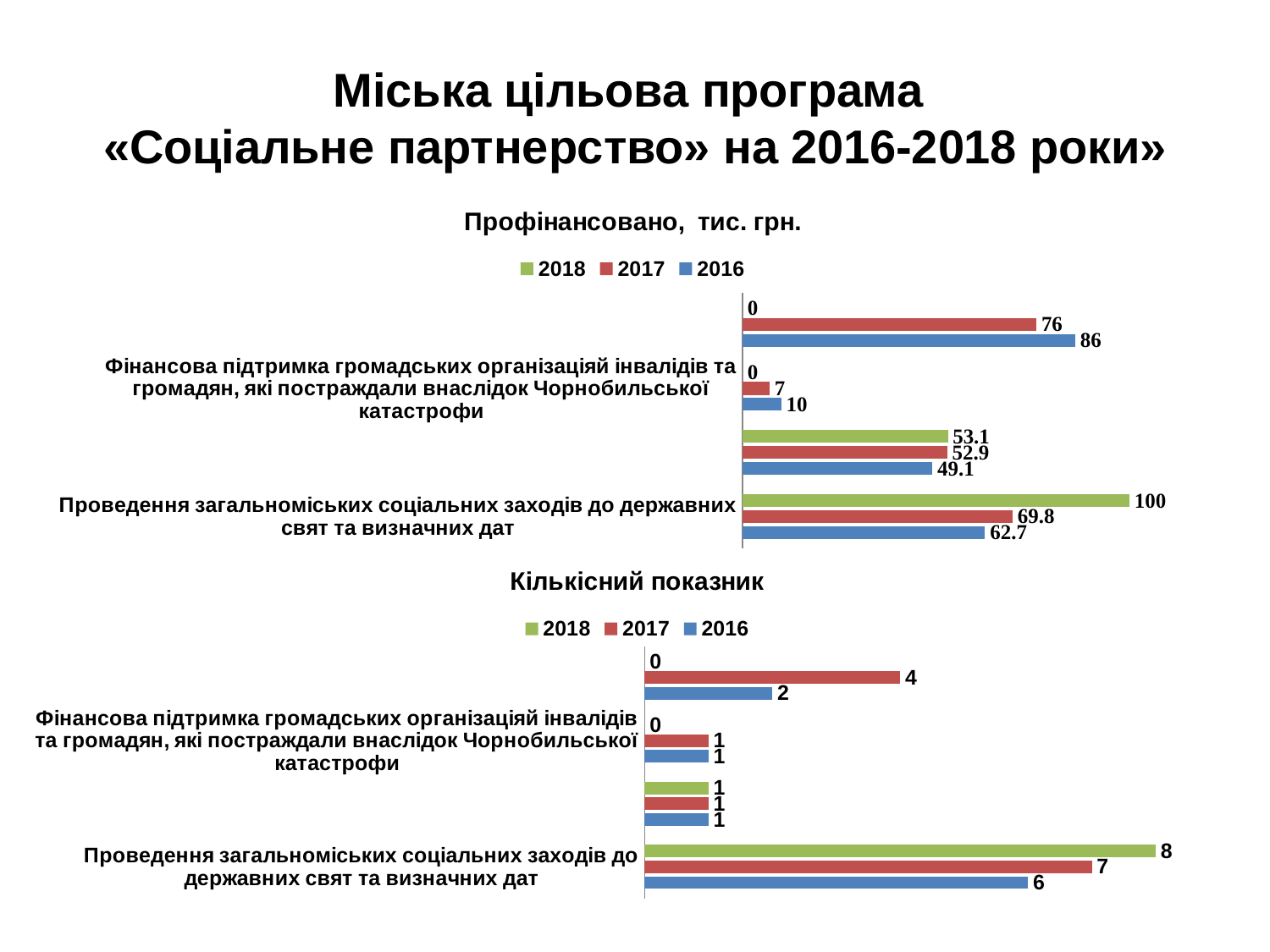
In the "Профінансовано, тис. грн." chart, what is the 2016 value in the bottom group of bars? 62.7 In the "Профінансовано, тис. грн." chart, what is the 2016 value in the topmost group of bars? 86 In the "Профінансовано, тис. грн." chart, in the topmost group of bars, which is larger: the 2017 value or the 2016 value? 2016 In the "Профінансовано, тис. грн." chart, what is the difference between the 2018 and 2017 values in the bottom group of bars? 30.2 In the "Профінансовано, тис. грн." chart, what is the 2017 value in the bottom group of bars? 69.8 In the "Кількісний показник" chart, what is the 2016 value in the bottom group of bars? 6 In the "Кількісний показник" chart, what is the 2018 value in the bottom group of bars? 8 In the "Профінансовано, тис. грн." chart, what is the highest value shown? 100 How many series does the legend of the "Профінансовано, тис. грн." chart list? 3 In the "Кількісний показник" chart, what is the 2017 value in the topmost group of bars? 4 What are the legend entries of the "Кількісний показник" chart? 2018, 2017, 2016 What kind of chart is the "Профінансовано, тис. грн." chart? bar chart